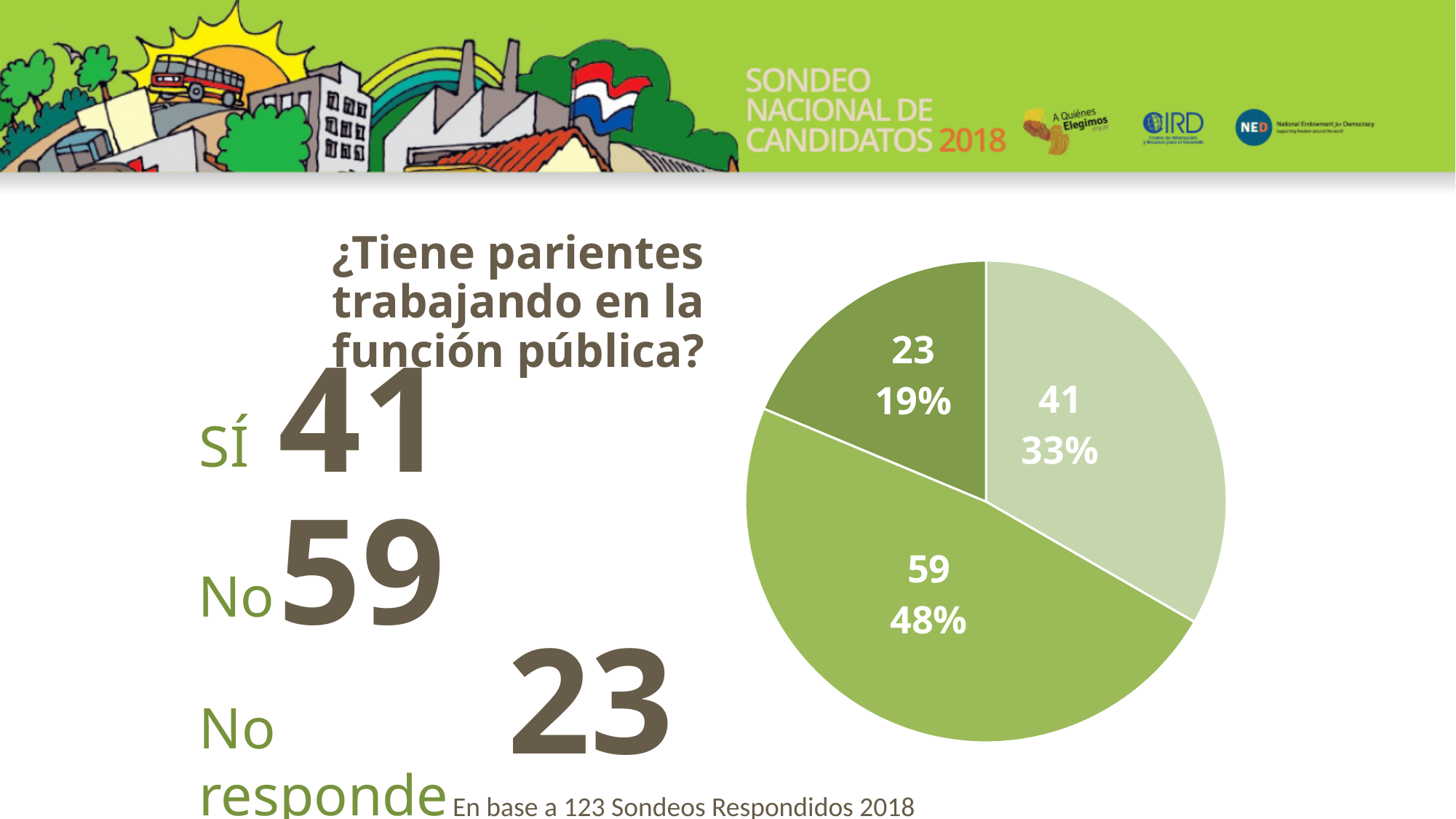
How many slices does the pie chart have? 3 Which response category has the largest slice of the pie? No What percentage share of the pie does the slice with 23 responses represent? 19% How many candidates are in the "No responde" category? 23 What percentage share of the pie does the slice with 59 responses represent? 48% How many candidates answered "Sí" to the question about relatives working in public service? 41 How many candidates answered "No"? 59 What percentage share of the pie does the slice with 41 responses represent? 33% Which is larger, the number of "Sí" responses or the number of "No responde" responses? Sí What kind of chart is shown on the slide? pie chart Which response category has the smallest slice of the pie? No responde What is the difference between the number of "No" responses and "Sí" responses? 18